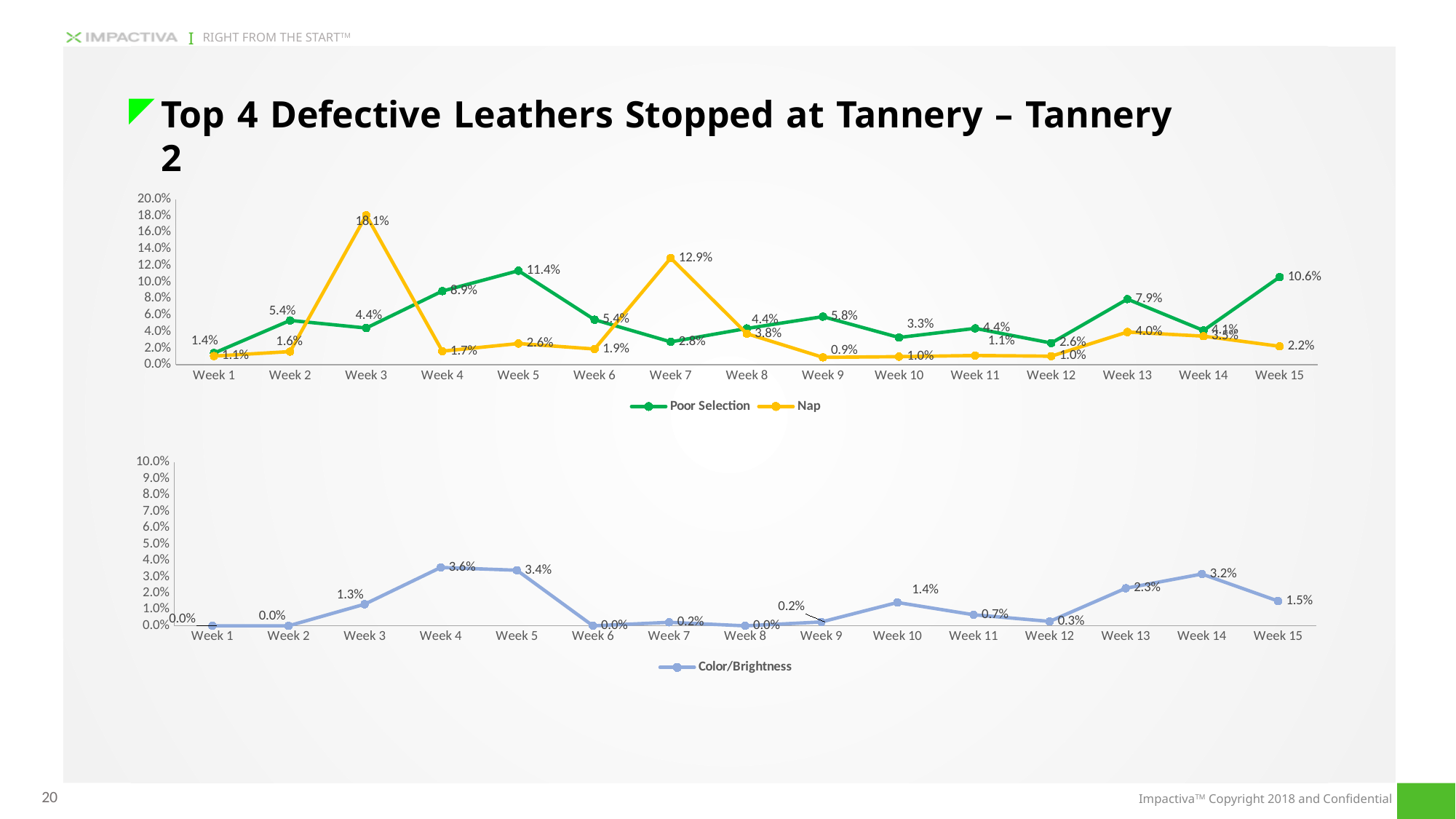
How many series does the legend of the top chart list? 2 In the top chart, what is the difference between the Poor Selection and Nap values in Week 7? 10.1% In the top chart, which is larger in Week 13: Poor Selection or Nap? Poor Selection In the top chart, which week has the lowest Nap value? Week 9 In the top chart, which week has the highest Nap value? Week 3 In the bottom chart, what is the Color/Brightness value for Week 4? 3.6% In the top chart, what is the Nap value for Week 3? 18.1% In the top chart, what is the Poor Selection value for Week 5? 11.4% How many weeks are plotted on the x axis of the bottom chart? 15 In the bottom chart, what is the difference between the Color/Brightness values for Week 14 and Week 15? 1.7% What type of chart is the bottom chart? Line chart In the bottom chart, which week has the highest Color/Brightness value? Week 4